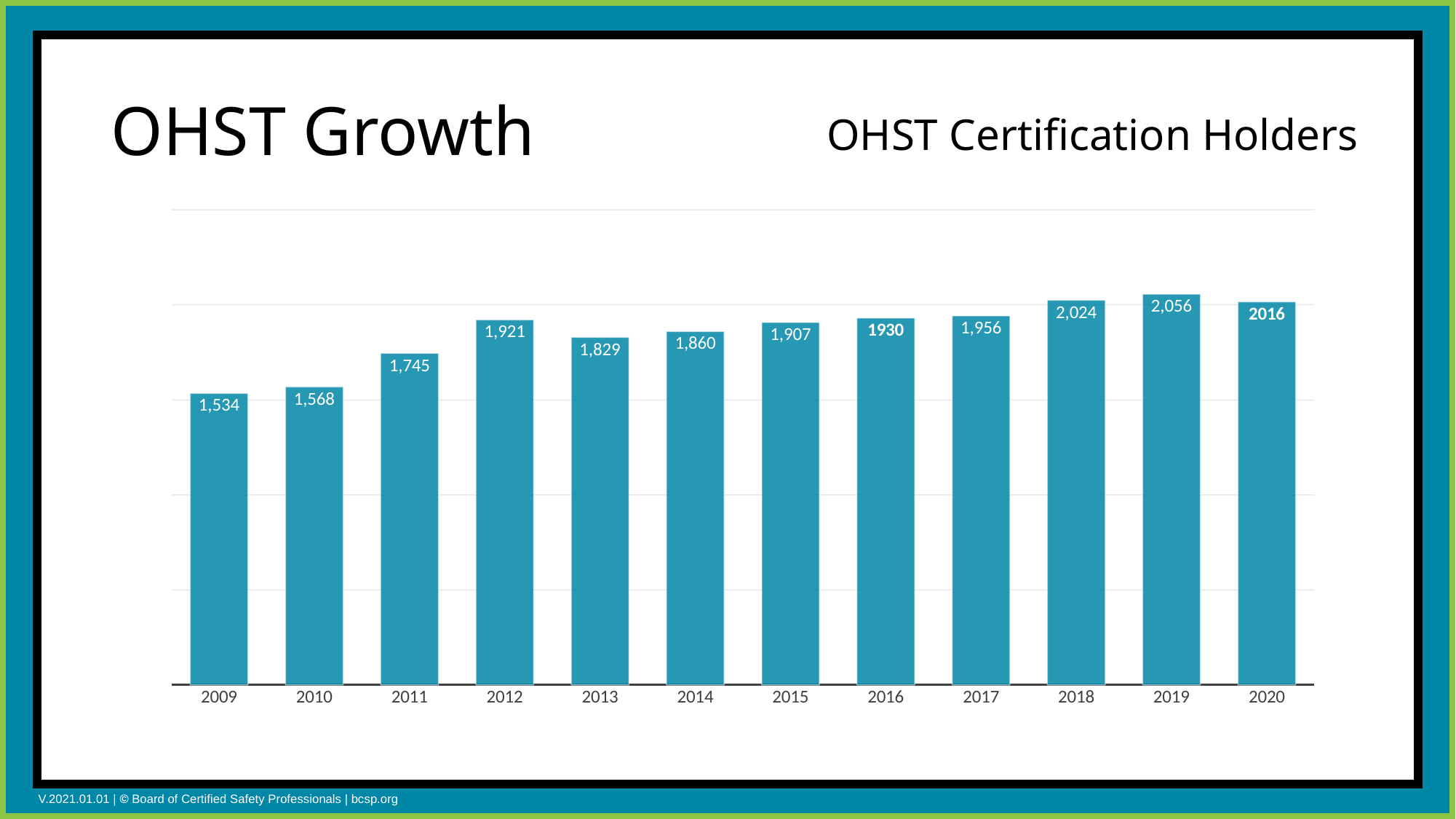
What is the value for 2019? 2,056 Which year has the highest value? 2019 What is the value for 2009? 1,534 Which is larger, the value for 2012 or the value for 2013? 2012 What is the title of the chart? OHST Certification Holders What kind of chart is this? Bar chart What is the difference between the values for 2019 and 2009? 522 Which year has the lowest value? 2009 What is the value for 2016? 1930 How many years are shown on the x axis? 12 What is the difference between the values for 2012 and 2013? 92 What is the value for 2020? 2016